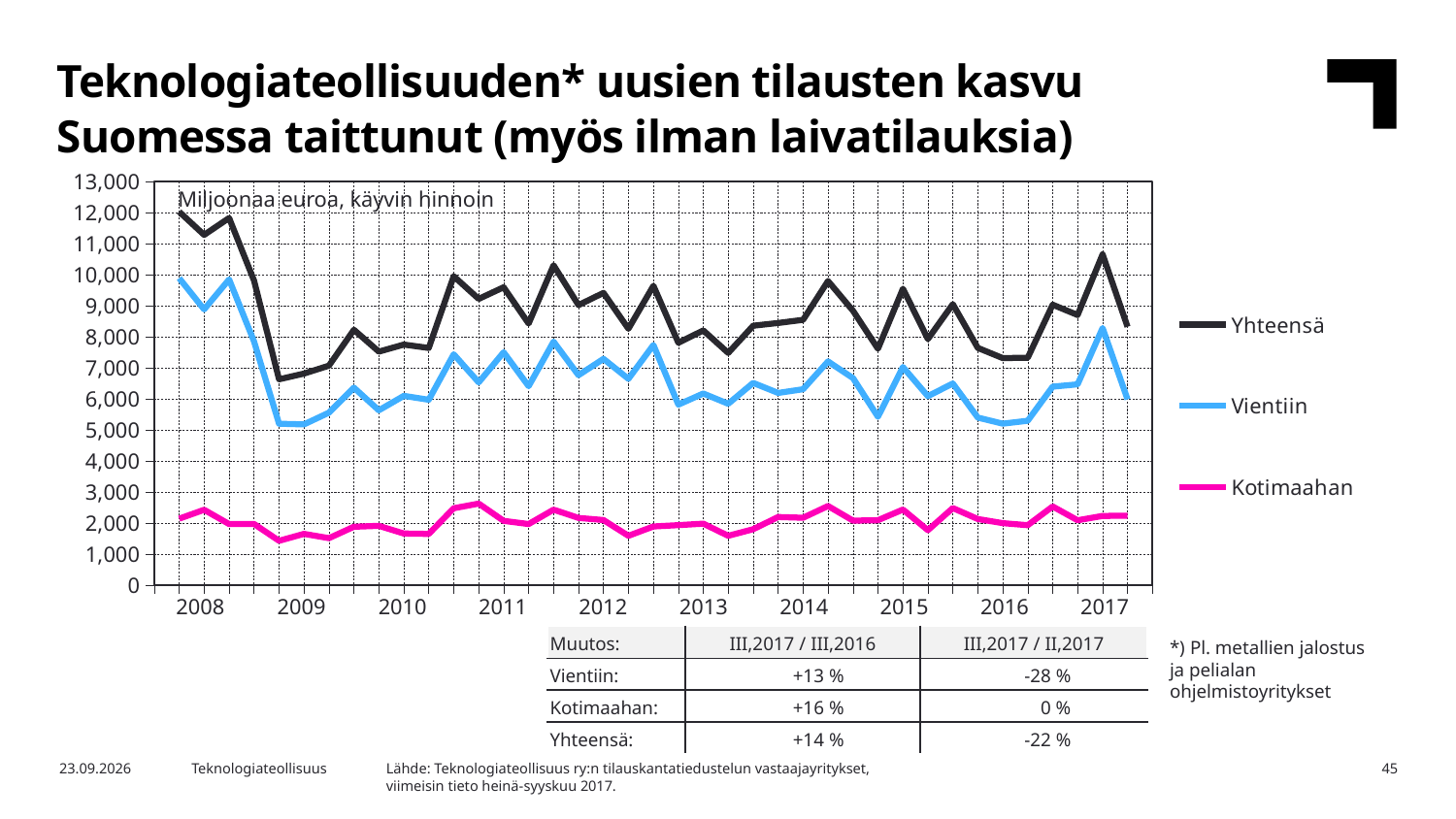
Which series are listed in the chart legend? Yhteensä, Vientiin, Kotimaahan How many series does the chart legend list? 3 What kind of chart is shown on the slide? Line chart What unit label is shown inside the chart area? Miljoonaa euroa, käyvin hinnoin Is the value for Kotimaahan at the start of 2008 greater or less than 3,000? less Is the lowest value for Vientiin in 2009 greater or less than 6,000? less How many years are labelled on the x axis of the chart? 10 Which is larger in 2017, the value for Vientiin or the value for Kotimaahan? Vientiin Is the value for Yhteensä at the start of 2008 greater or less than 11,000? greater Which series has the highest values throughout the chart? Yhteensä Which series has the lowest values throughout the chart? Kotimaahan Does the Yhteensä series rise or fall from 2008 to 2009? Fall